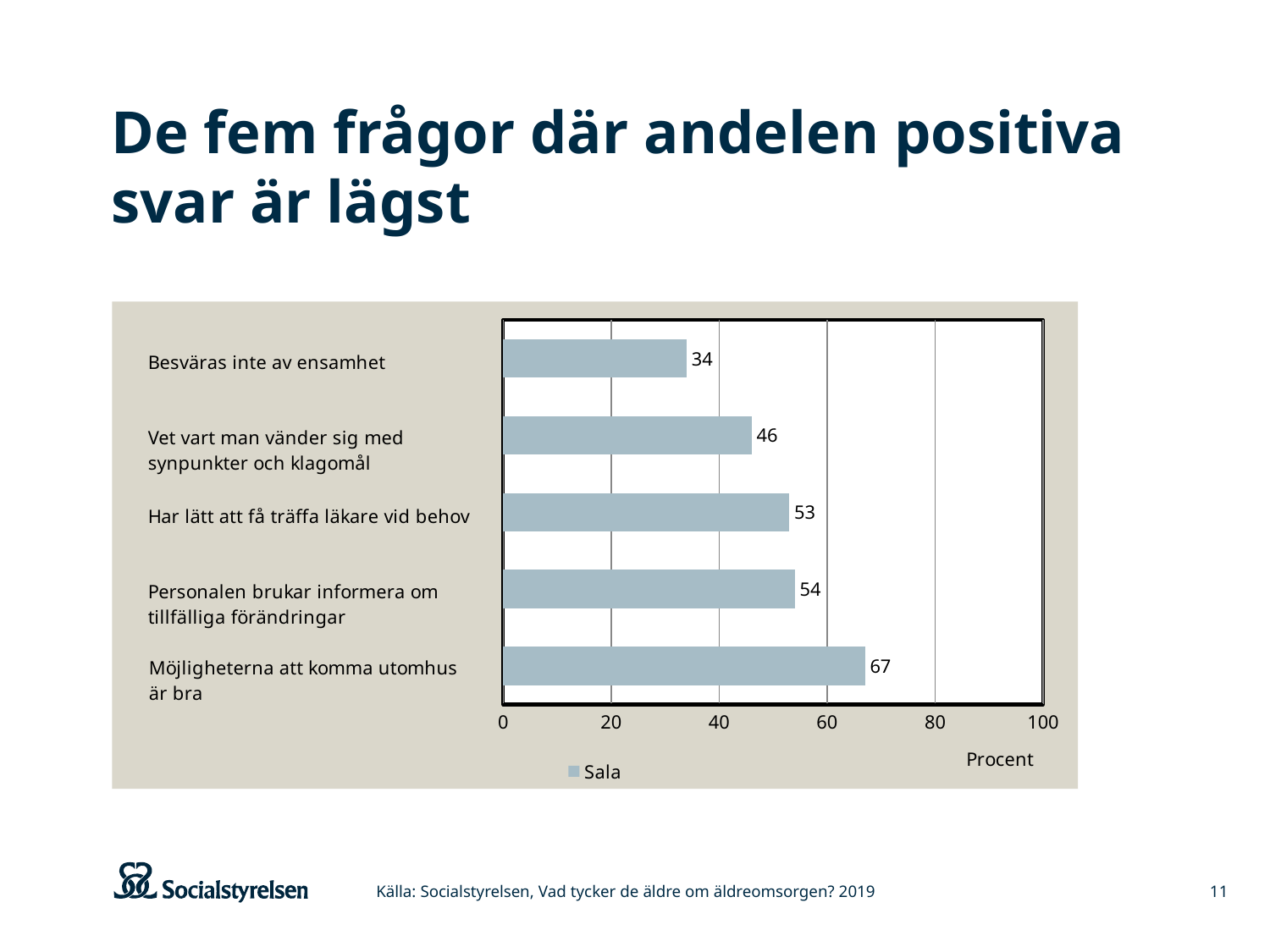
What series name does the legend show? Sala What is the difference between the values for "Vet vart man vänder sig med synpunkter och klagomål" and "Besväras inte av ensamhet"? 12 What is the value for "Har lätt att få träffa läkare vid behov"? 53 Is the value for "Personalen brukar informera om tillfälliga förändringar" greater or less than 40? greater What is the value for "Möjligheterna att komma utomhus är bra"? 67 Which category has the highest value? Möjligheterna att komma utomhus är bra Which category has the lowest value? Besväras inte av ensamhet Which is larger, the value for "Vet vart man vänder sig med synpunkter och klagomål" or the value for "Möjligheterna att komma utomhus är bra"? Möjligheterna att komma utomhus är bra What kind of chart is shown on the slide? Bar chart How many categories are shown in the chart? 5 What is the difference between the values for "Möjligheterna att komma utomhus är bra" and "Besväras inte av ensamhet"? 33 What is the value for "Besväras inte av ensamhet"? 34